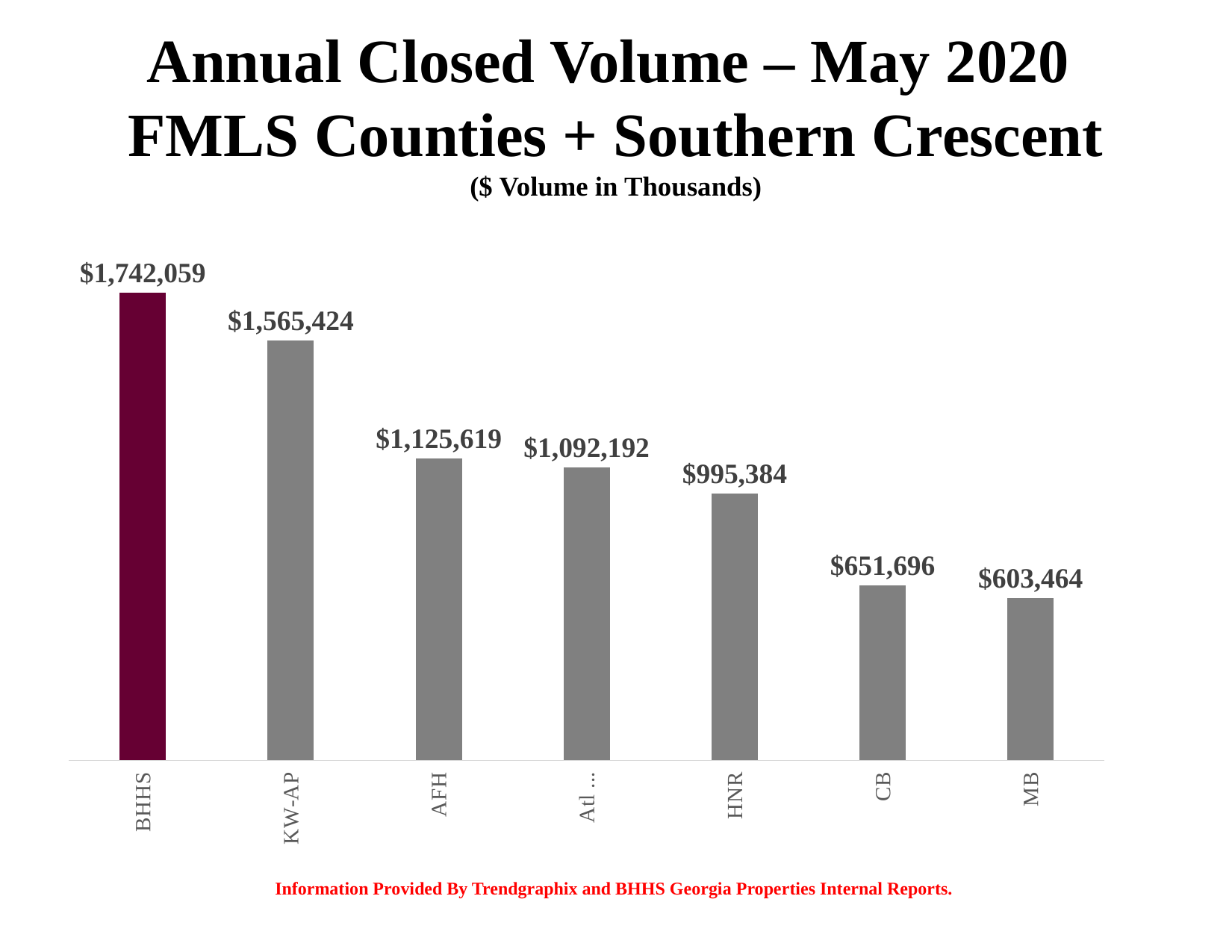
How many companies are shown in the chart? 7 What is the difference between the annual closed volume of BHHS and KW-AP? $176,635 What is the annual closed volume for MB? $603,464 What is the annual closed volume for HNR? $995,384 What is the annual closed volume for BHHS? $1,742,059 What type of chart is shown on the slide? Bar chart Which company has the highest annual closed volume? BHHS Do the values rise or fall from left to right across the chart? Fall What is the annual closed volume for KW-AP? $1,565,424 Which has a larger annual closed volume, AFH or HNR? AFH What is the difference between the annual closed volume of CB and MB? $48,232 Which company has the lowest annual closed volume? MB